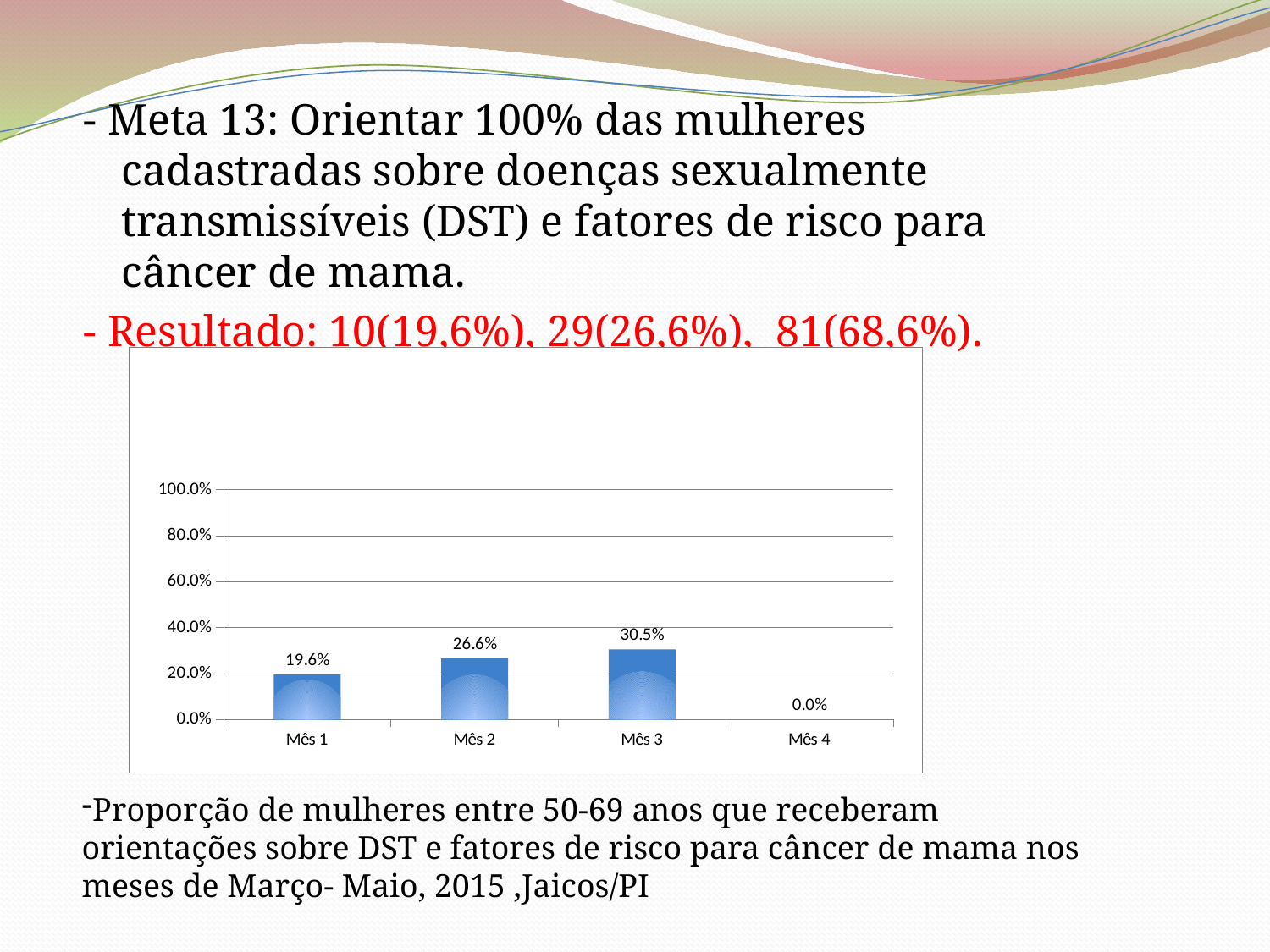
What kind of chart is shown on the slide? bar chart What is the value for Mês 3? 30.5% What is the value for Mês 1? 19.6% What is the difference between the values for Mês 2 and Mês 1? 7.0% What is the value for Mês 4? 0.0% Is the value for Mês 3 greater or less than 40.0%? less Which month has the highest value? Mês 3 Which is larger, the value for Mês 2 or the value for Mês 3? Mês 3 What is the value for Mês 2? 26.6% How many categories are shown on the x axis? 4 What is the difference between the values for Mês 3 and Mês 1? 10.9% Which month has the lowest value? Mês 4